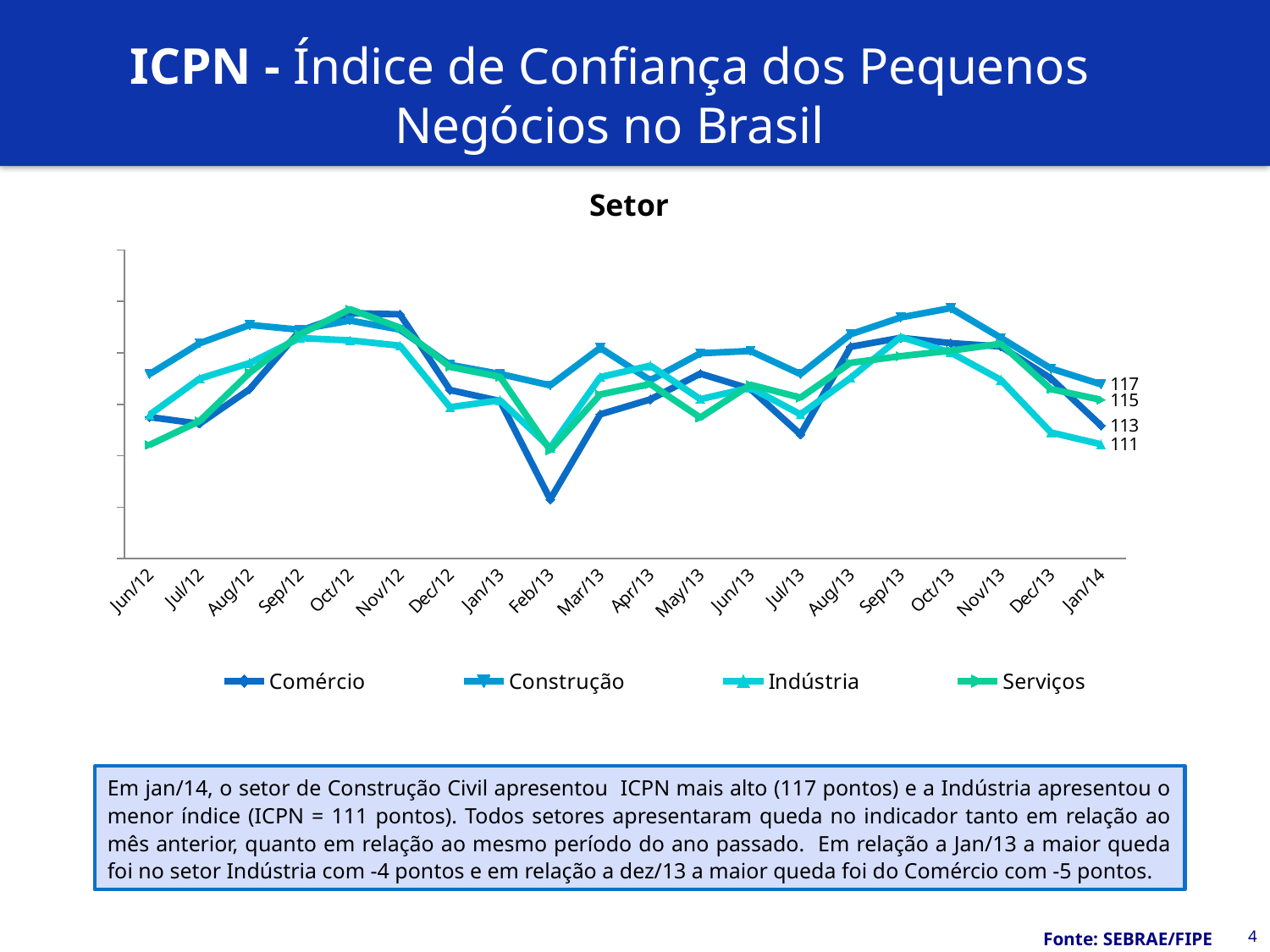
In which month does the Comércio line reach its lowest point? Feb/13 What kind of chart is shown on the slide? line chart What is the value for Comércio in Jan/14? 113 Which series has the lowest value in Jan/14? Indústria How many months are shown on the x axis? 20 Which series has the highest value in Jan/14? Construção What is the difference between Construção and Indústria in Jan/14? 6 What is the value for Serviços in Jan/14? 115 How many series does the legend list? 4 What is the value for Construção in Jan/14? 117 What is the value for Indústria in Jan/14? 111 In Jan/14, which is larger: Serviços or Comércio? Serviços